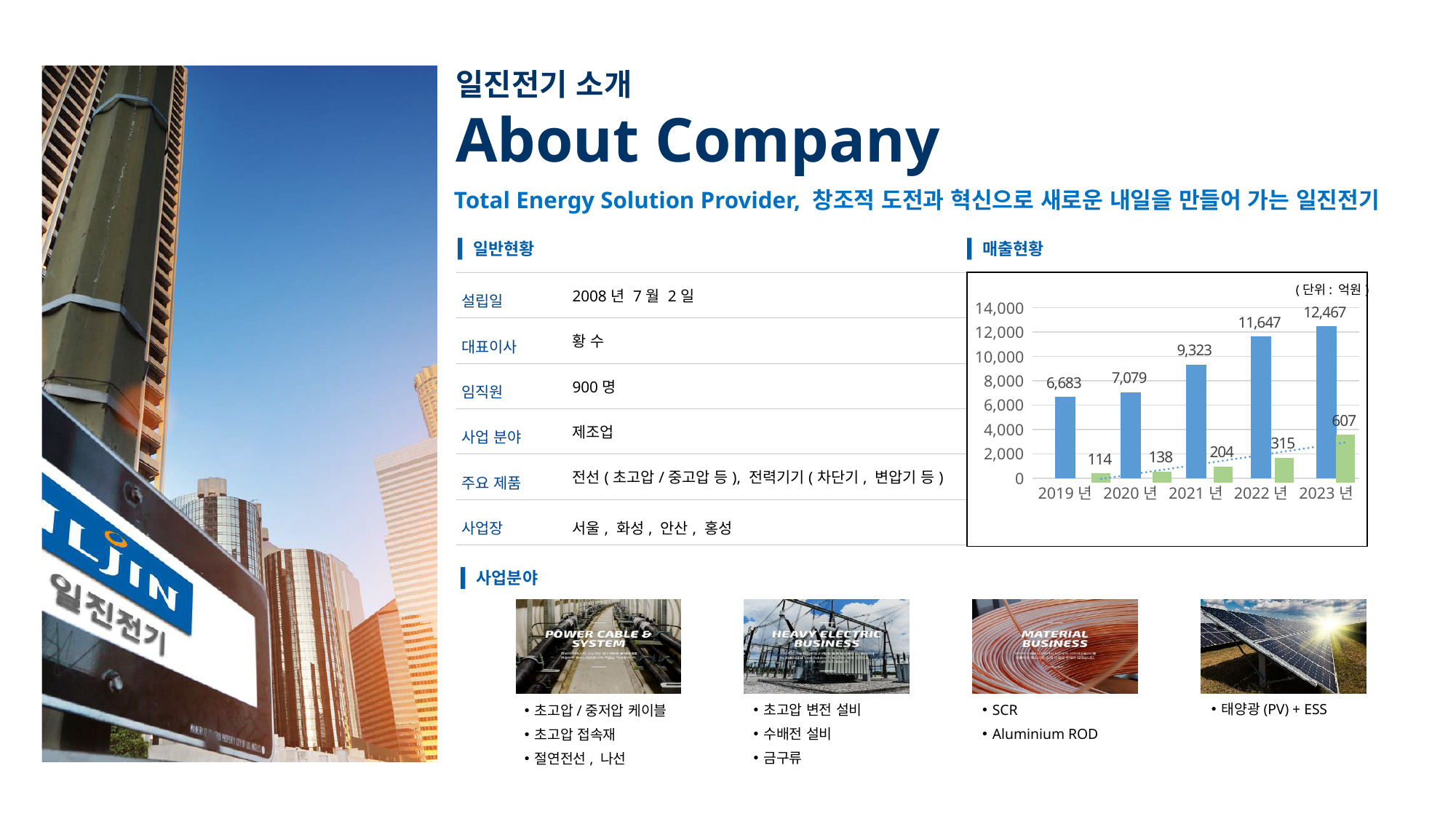
Which year has the highest blue bar in the 매출현황 chart? 2023 년 What kind of chart is the 매출현황 chart? Bar chart What is the difference between the blue bar values for 2023 년 and 2022 년 in the 매출현황 chart? 820 Which year has the lowest green bar in the 매출현황 chart? 2019 년 What is the value of the blue bar for 2023 년 in the 매출현황 chart? 12,467 Do the blue bar values rise or fall from 2019 년 to 2023 년 in the 매출현황 chart? Rise What is the value of the green bar for 2022 년 in the 매출현황 chart? 315 How many years are shown on the x axis of the 매출현황 chart? 5 What is the value of the blue bar for 2019 년 in the 매출현황 chart? 6,683 In the 매출현황 chart, is the blue bar for 2021 년 greater or less than 8,000? greater What is the difference between the green bar values for 2023 년 and 2022 년 in the 매출현황 chart? 292 What is the value of the green bar for 2020 년 in the 매출현황 chart? 138